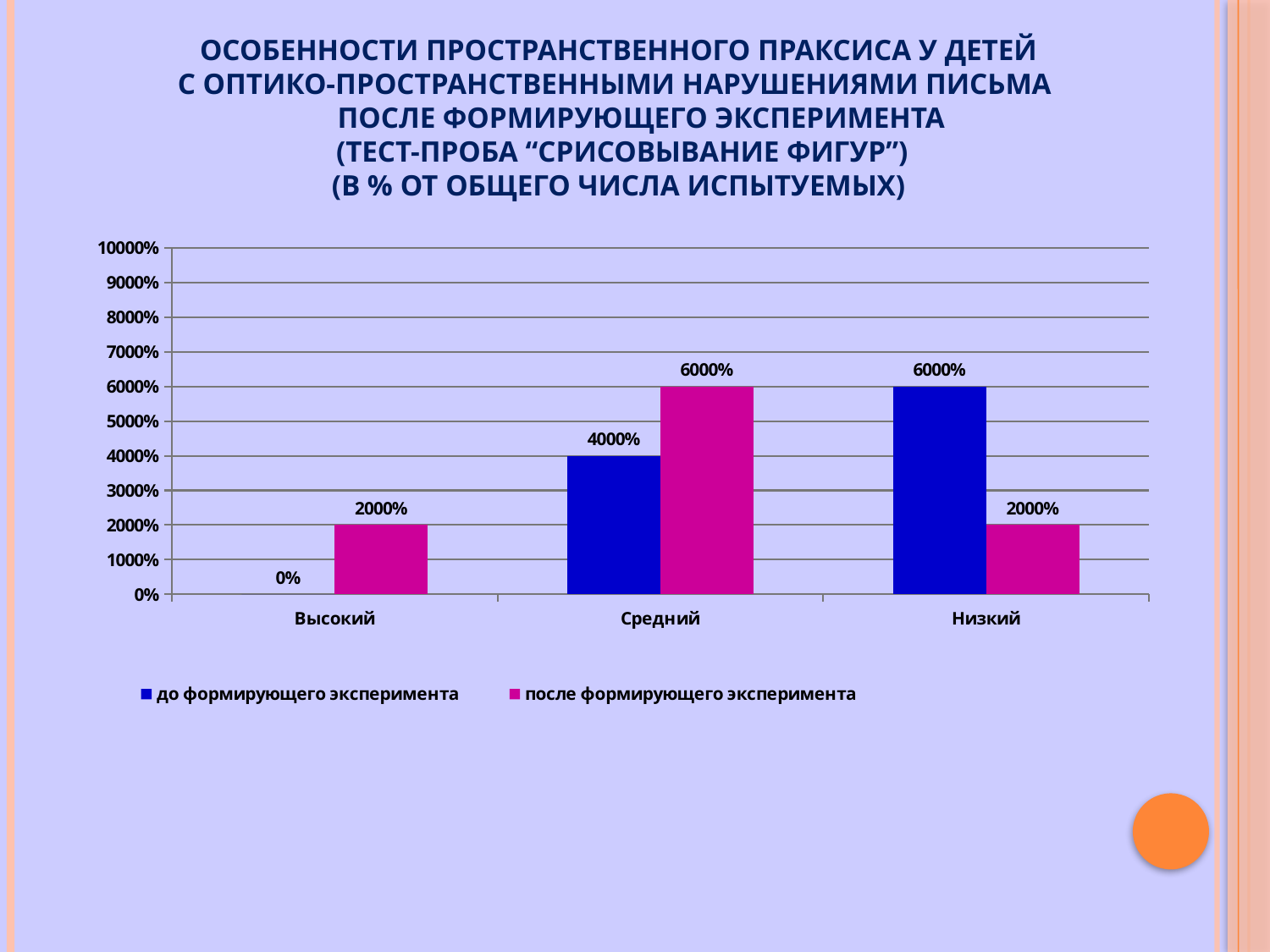
How many categories are shown on the x axis? 3 For Низкий, which series has the larger value: до формирующего эксперимента or после формирующего эксперимента? до формирующего эксперимента How many series does the legend list? 2 What is the difference between the после формирующего эксперимента and до формирующего эксперимента values for Средний? 2000% Which category has the highest value in the series до формирующего эксперимента? Низкий What kind of chart is shown on the slide? bar chart What colour are the bars for the series после формирующего эксперимента? magenta What is the value for Средний in the series до формирующего эксперимента? 4000% What is the value for Высокий in the series после формирующего эксперимента? 2000% What is the value for Высокий in the series до формирующего эксперимента? 0% What is the value for Низкий in the series после формирующего эксперимента? 2000%